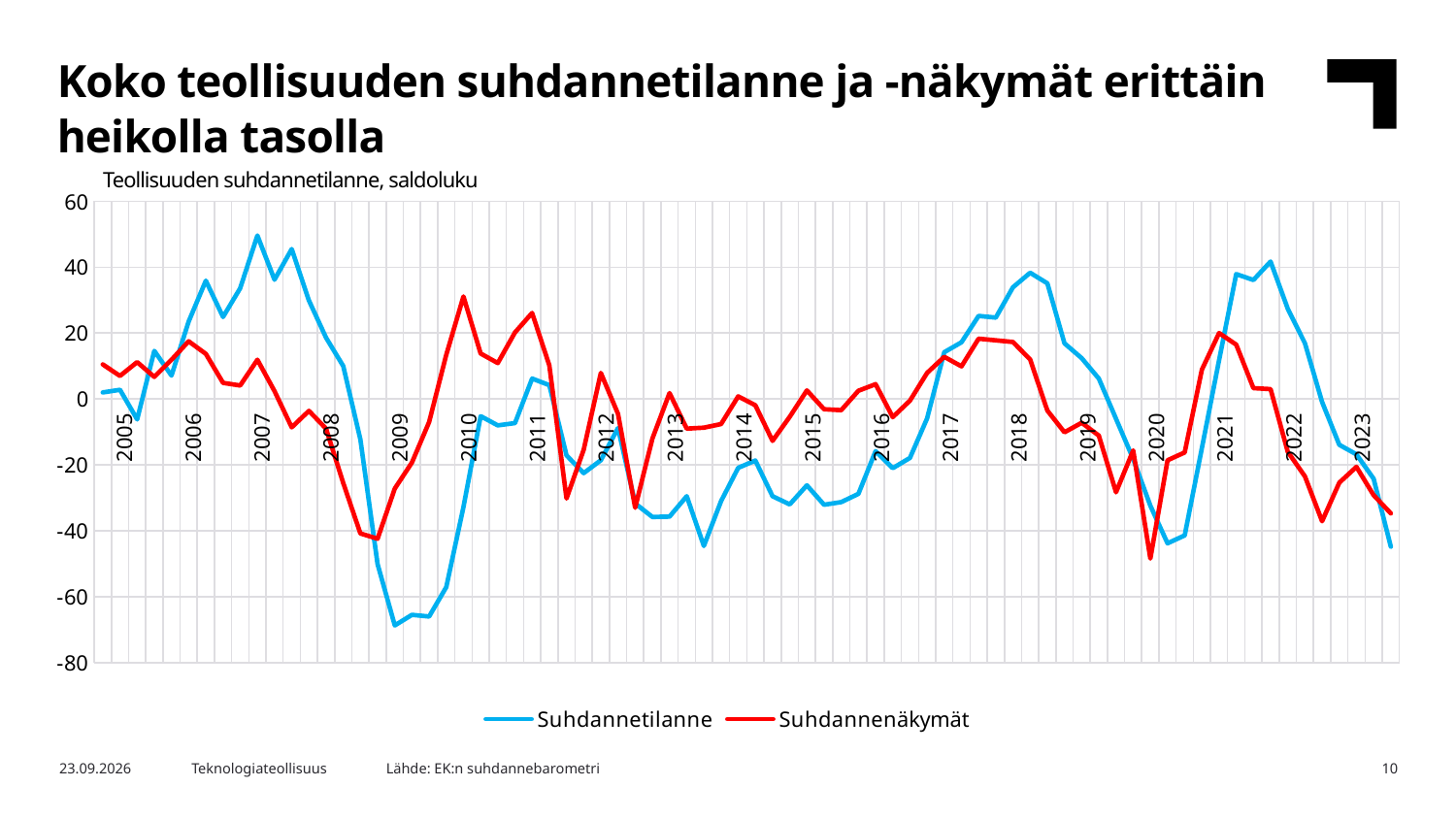
How many series does the legend list? 2 Which series reaches the higher maximum value over the whole period, Suhdannetilanne or Suhdannenäkymät? Suhdannetilanne Is the peak of the Suhdannenäkymät line around 2010 greater or less than 20? greater What are the two series named in the legend? Suhdannetilanne and Suhdannenäkymät Does the Suhdannetilanne line rise or fall from its 2021 peak to the end of 2023? fall Is the lowest value of the Suhdannetilanne line, reached around 2009, greater or less than -60? less Is the final 2023 value of the Suhdannetilanne line greater or less than -40? less Which series reaches the lower minimum value over the whole period, Suhdannetilanne or Suhdannenäkymät? Suhdannetilanne What kind of chart is shown on the slide? line chart What is the title printed above the chart? Teollisuuden suhdannetilanne, saldoluku